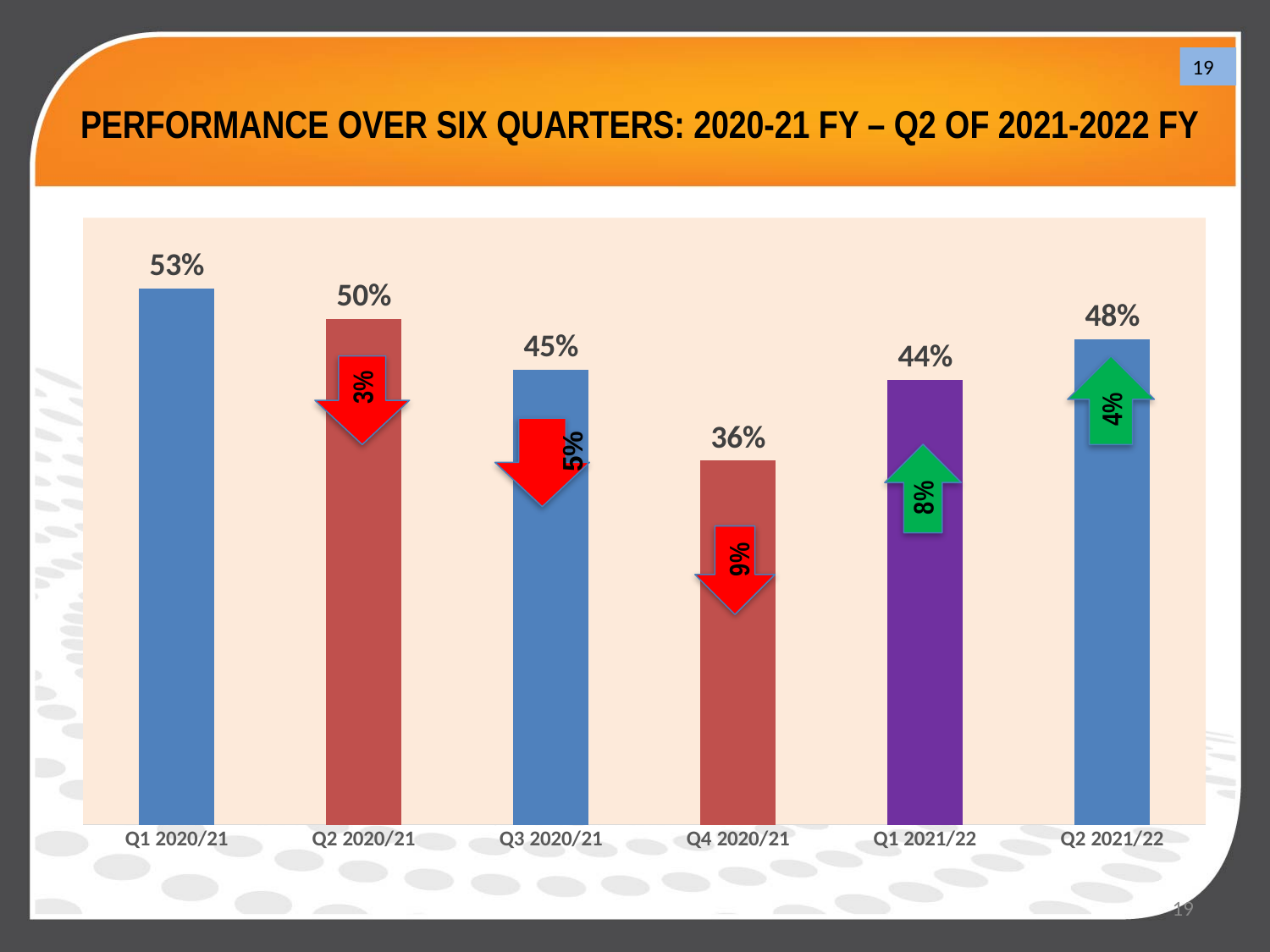
What is the value for Q1 2020/21? 53% Which is larger, the value for Q2 2020/21 or the value for Q3 2020/21? Q2 2020/21 What is the difference between the values for Q1 2020/21 and Q4 2020/21? 17% What change does the arrow on the Q4 2020/21 bar indicate? 9% decrease What is the difference between the values for Q2 2021/22 and Q1 2021/22? 4% How many quarters are shown on the chart? 6 What is the value for Q2 2021/22? 48% What is the value for Q4 2020/21? 36% What kind of chart is shown on the slide? Bar chart Which quarter has the highest value? Q1 2020/21 Do the values rise or fall from Q1 2020/21 to Q4 2020/21? Fall Which quarter has the lowest value? Q4 2020/21